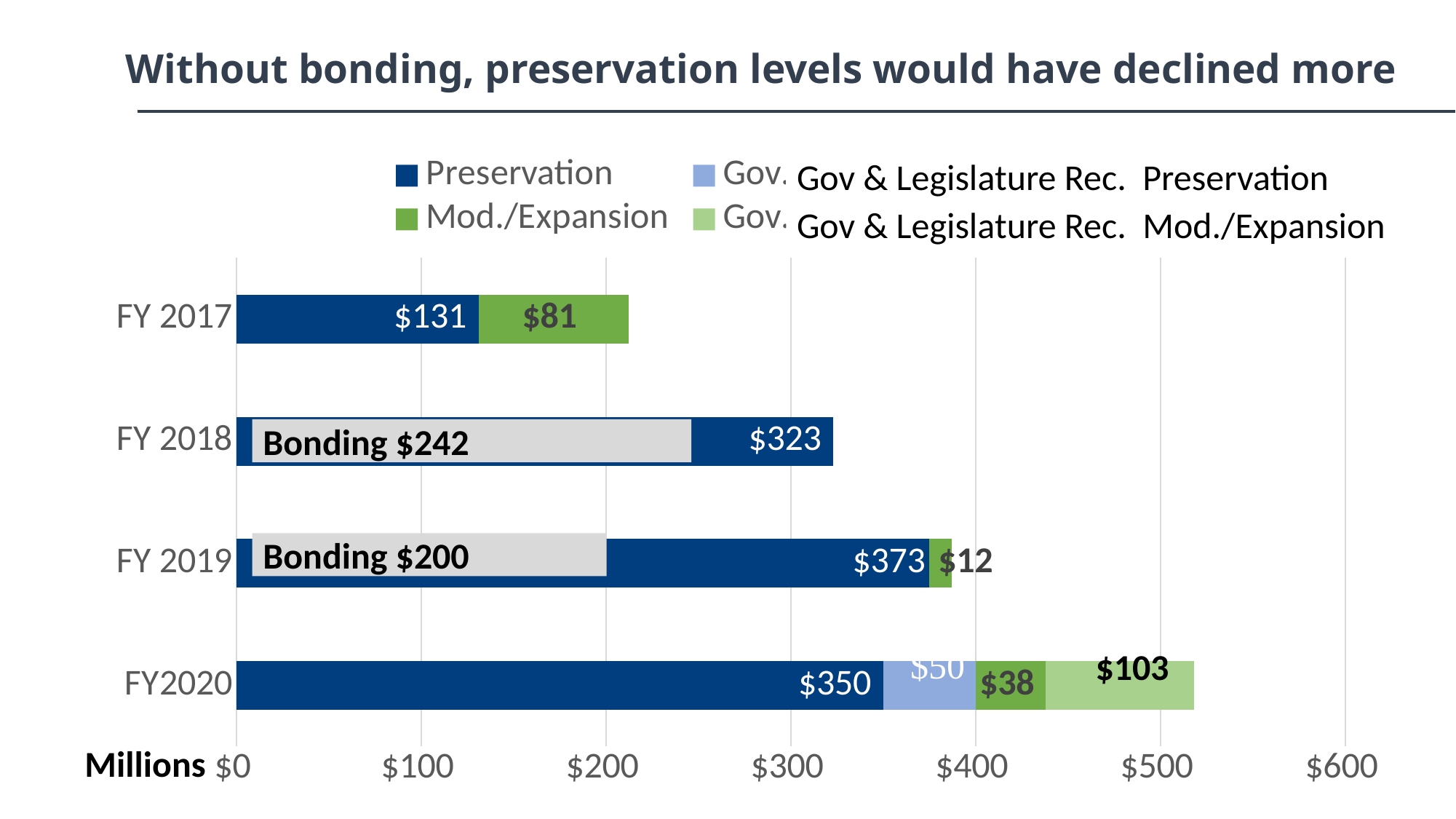
How much bonding is shown for FY 2018? $242 What is the total of the stacked bar for FY 2017? $212 What is the difference between the Preservation values for FY 2019 and FY 2018? $50 Which fiscal year has the lowest Preservation value? FY 2017 Which fiscal year has the highest Preservation value? FY 2019 What is the Gov & Legislature Rec. Preservation value for FY2020? $50 What is the Preservation value for FY 2017? $131 What kind of chart is shown on the slide? Bar chart What is the Preservation value for FY 2019? $373 What is the Mod./Expansion value for FY 2017? $81 Is the Preservation value for FY 2018 larger or smaller than the Preservation value for FY2020? smaller What is the Preservation value for FY 2018? $323